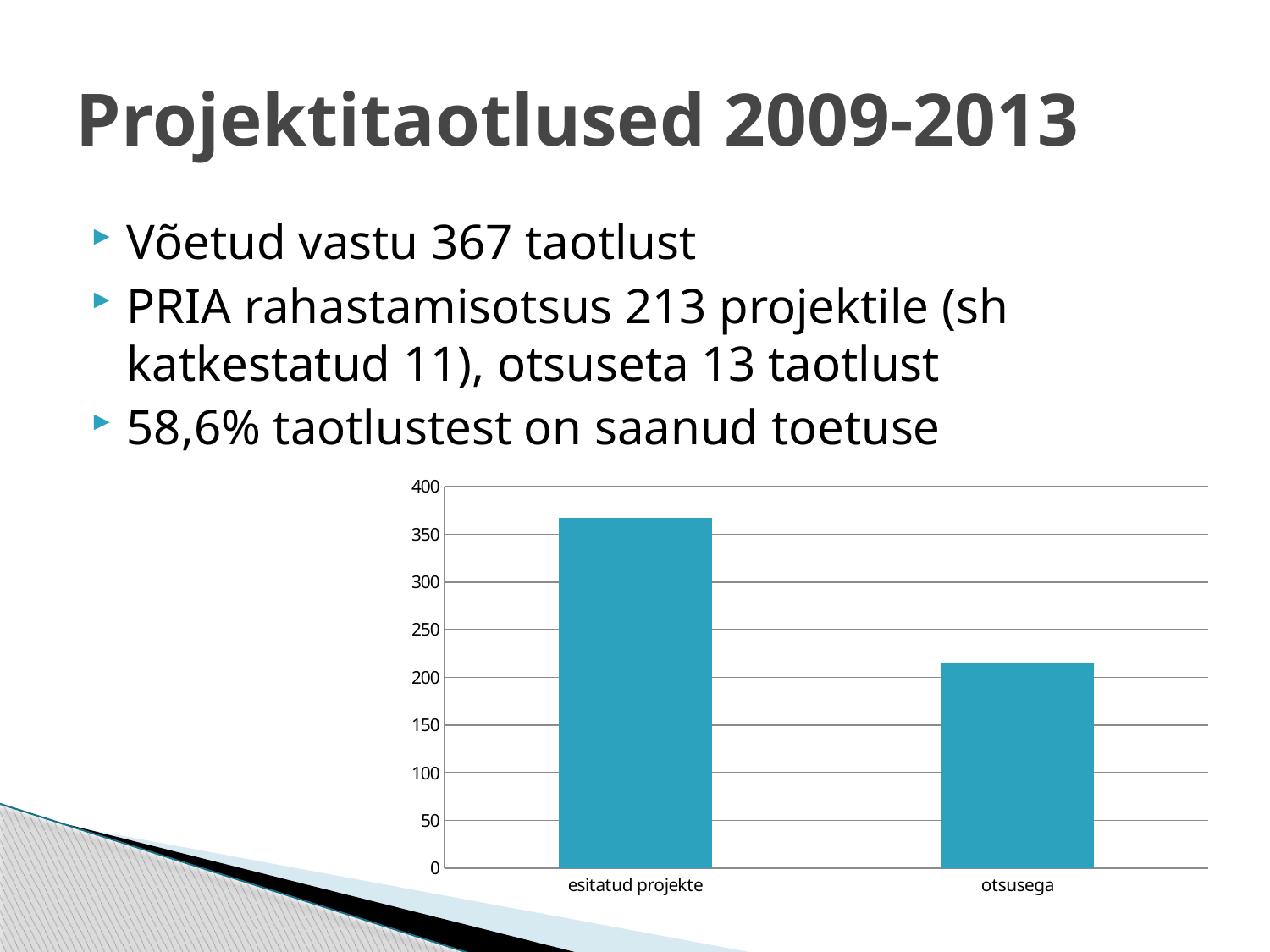
Do the bar values rise or fall from left to right along the x axis? fall How many bars does the chart show? 2 Is the value for esitatud projekte greater or less than 350? greater Which category has the lowest bar in the chart? otsusega What kind of chart is shown on the slide? bar chart Is the value for otsusega greater or less than 200? greater Which category has the highest bar in the chart? esitatud projekte Is the value for otsusega greater or less than 250? less Which bar is taller, esitatud projekte or otsusega? esitatud projekte What is the highest value shown on the chart's vertical axis? 400 What is the label of the first category on the x axis of the chart? esitatud projekte